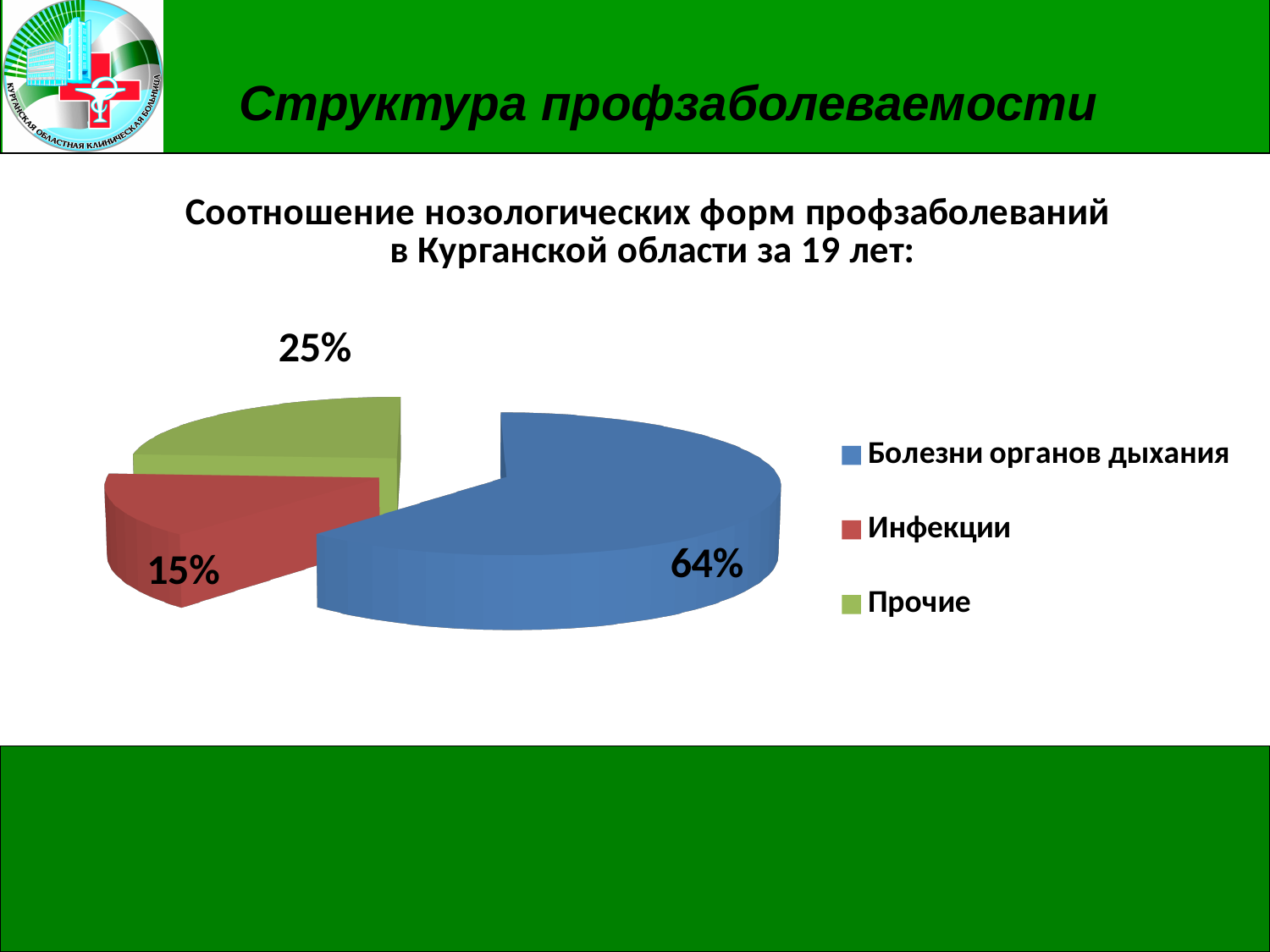
What type of chart is shown on the slide? pie chart How many categories does the pie chart show? 3 What is the difference between the shares of Прочие and Инфекции? 10% What is the title of the chart? Соотношение нозологических форм профзаболеваний в Курганской области за 19 лет: Which category has the largest share of the pie? Болезни органов дыхания What is the difference between the shares of Болезни органов дыхания and Прочие? 39% Which category has the smallest share of the pie? Инфекции What colour is the slice for Инфекции? red What share of the pie does Болезни органов дыхания have? 64% What share of the pie does Инфекции have? 15% Which is larger, the share of Прочие or the share of Инфекции? Прочие What share of the pie does Прочие have? 25%